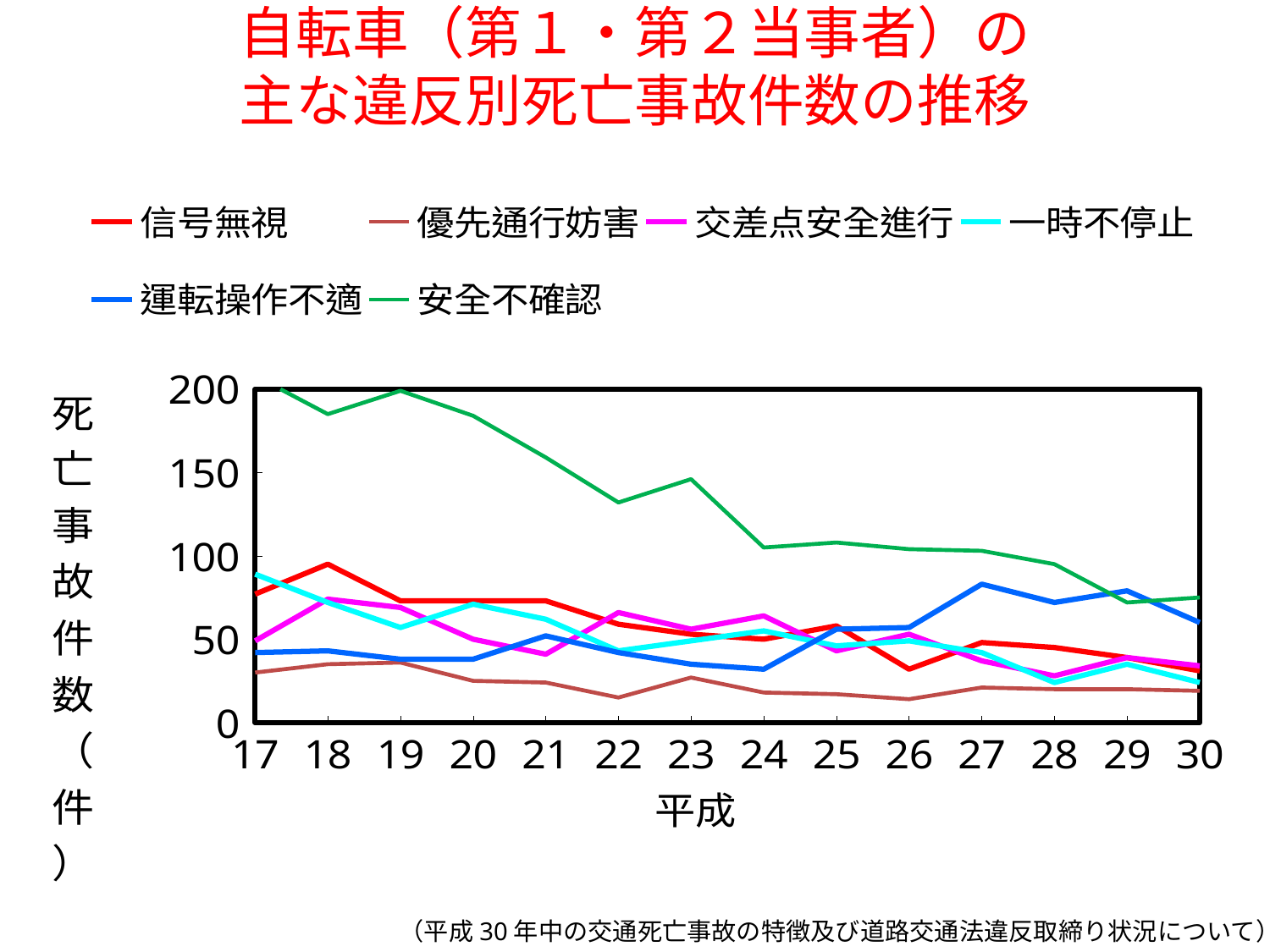
Is the value for 安全不確認 at 平成24 greater or less than 150? less Is the value for 安全不確認 at 平成17 greater or less than 150? greater What kind of chart is shown on the slide? line chart How many series does the legend list? 6 Is the value for 運転操作不適 at 平成27 greater or less than 50? greater Which series has the highest value at 平成17? 安全不確認 At 平成30, which is larger: 安全不確認 or 優先通行妨害? 安全不確認 How many years are plotted along the x axis? 14 Which series has the lowest value at 平成22? 優先通行妨害 Does the 安全不確認 line rise or fall from 平成17 to 平成30? fall What is the label of the x axis? 平成